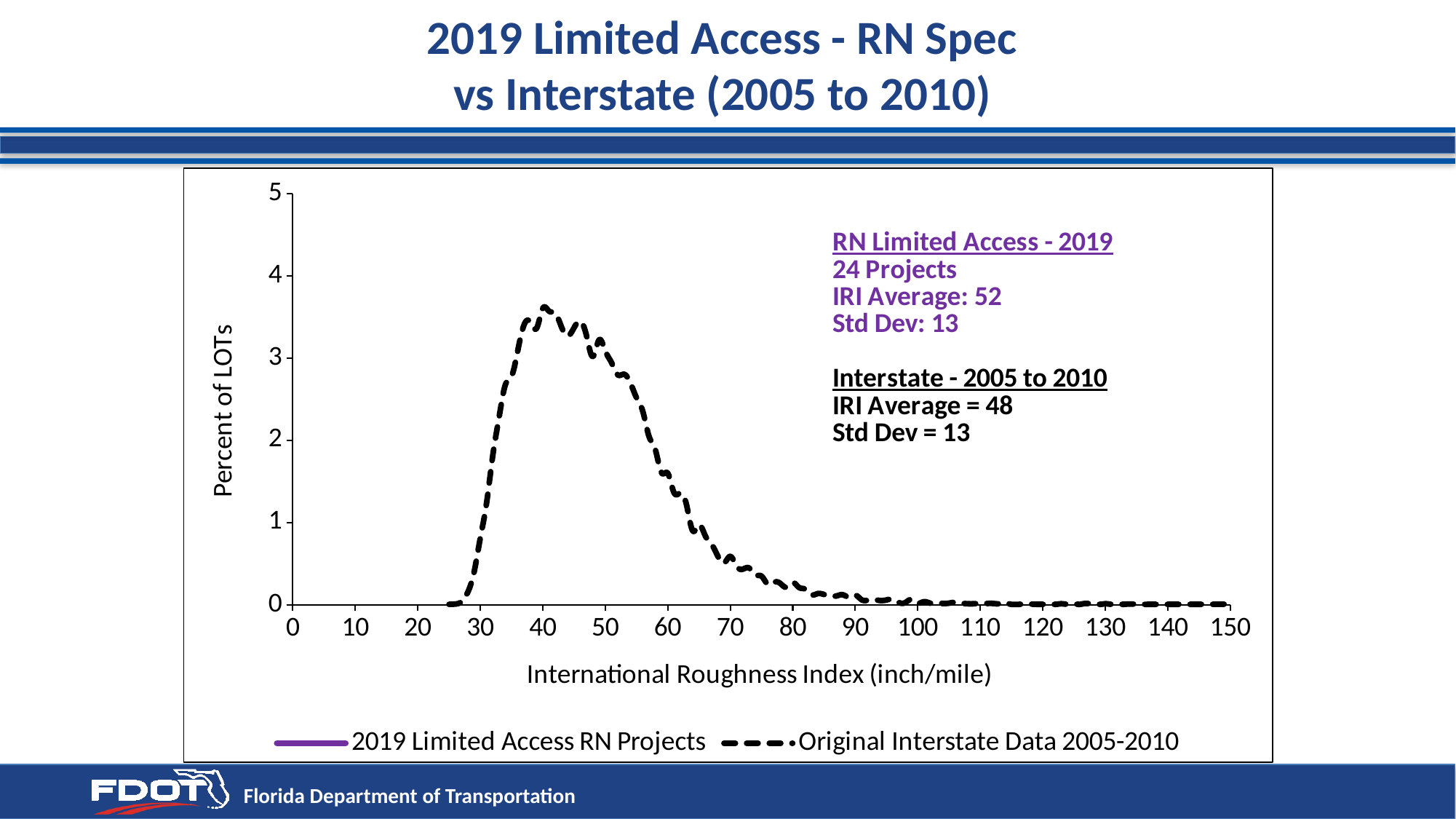
Between an IRI of 30 and an IRI of 40, does the Original Interstate Data 2005-2010 line rise or fall? rise What kind of chart is shown on the slide? line chart According to the text on the chart, what is the IRI Average for Interstate - 2005 to 2010? 48 According to the text on the chart, what is the IRI Average for RN Limited Access - 2019? 52 What is the label of the x axis? International Roughness Index (inch/mile) Is the value of the Original Interstate Data 2005-2010 line at an IRI of 30 greater or less than 2? less Is the peak value of the Original Interstate Data 2005-2010 line greater or less than 4? less Between an IRI of 40 and an IRI of 80, does the Original Interstate Data 2005-2010 line rise or fall? fall How many series does the chart legend list? 2 What is the label of the y axis? Percent of LOTs Is the peak value of the Original Interstate Data 2005-2010 line greater or less than 3? greater